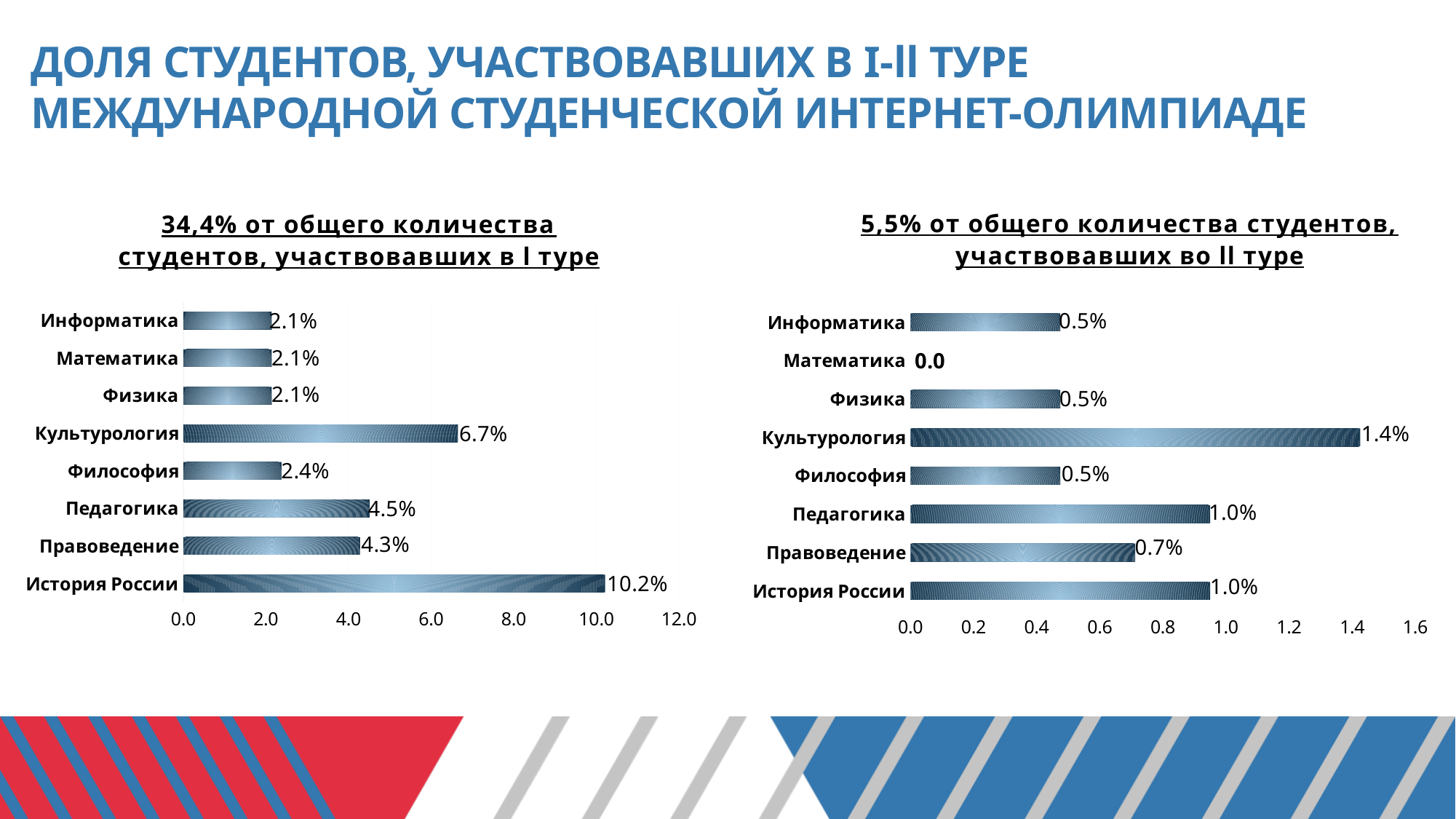
In the right chart (II тур), what is the value for Правоведение? 0.7% In the left chart (I тур), which is larger: Культурология or Педагогика? Культурология In the right chart (II тур), what is the difference between Культурология and Педагогика? 0.4% In the left chart (I тур), what is the difference between Педагогика and Правоведение? 0.2% In the left chart (I тур), which category has the highest value? История России What type of chart is the right chart (II тур)? Bar chart What is the title of the left chart? 34,4% от общего количества студентов, участвовавших в I туре In the right chart (II тур), what is the value for Культурология? 1.4% In the right chart (II тур), which category has the lowest value? Математика In the left chart (I тур), what is the value for Культурология? 6.7% In the left chart (I тур), how many categories are shown? 8 In the left chart (I тур), what is the value for История России? 10.2%